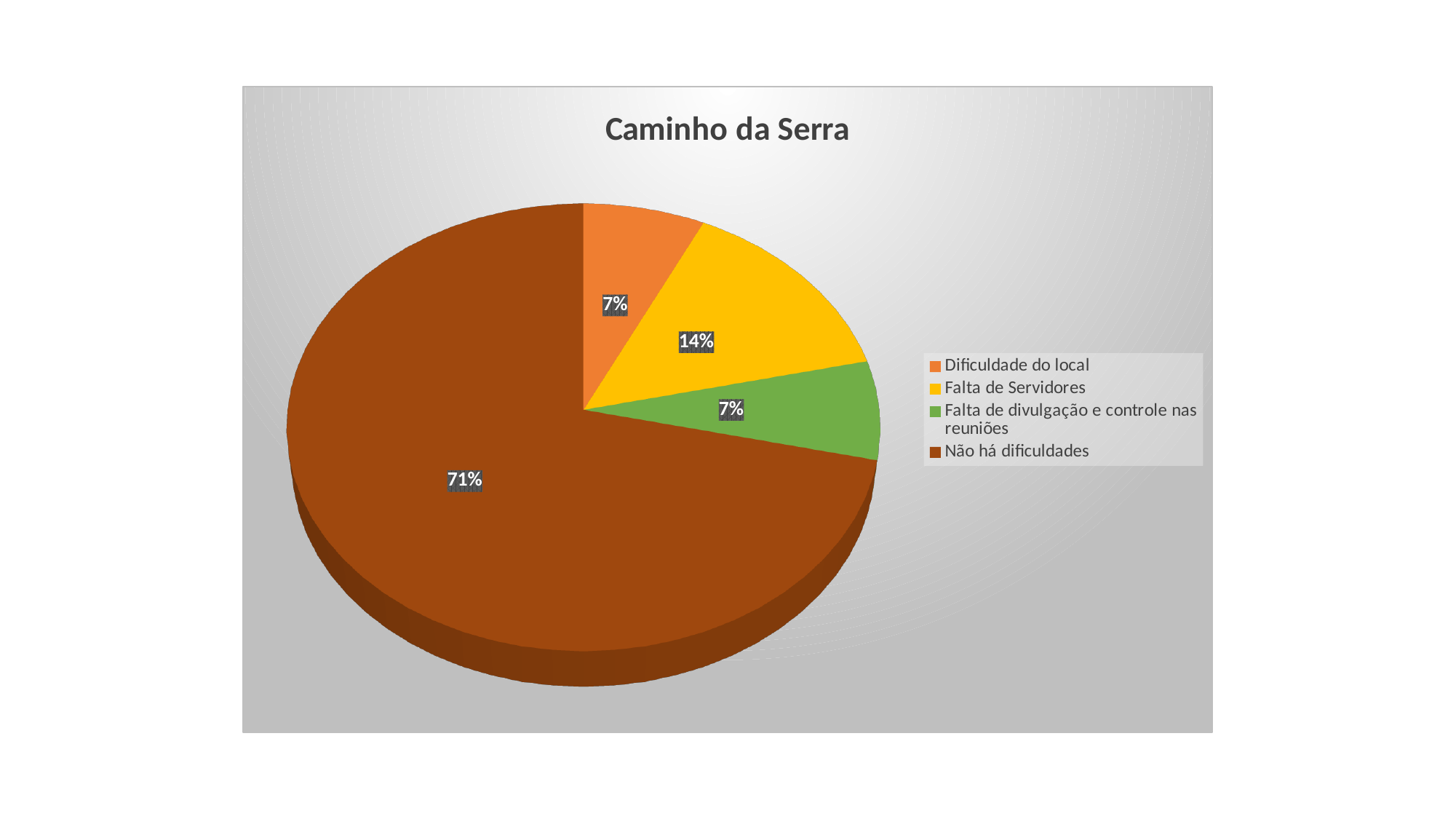
How many categories does the legend list? 4 Which is larger, the "Falta de Servidores" slice or the "Dificuldade do local" slice? Falta de Servidores What is the title of the chart? Caminho da Serra What is the value shown for "Falta de divulgação e controle nas reuniões"? 7% What colour is the "Falta de Servidores" slice? Yellow What is the value shown for "Dificuldade do local"? 7% What share of the pie does "Falta de Servidores" take? 14% What kind of chart is shown on the slide? Pie chart Which category has the largest slice of the pie? Não há dificuldades What share of the pie does "Não há dificuldades" take? 71% What is the difference between the "Falta de Servidores" slice and the "Falta de divulgação e controle nas reuniões" slice? 7% What is the difference between the "Não há dificuldades" slice and the "Falta de Servidores" slice? 57%